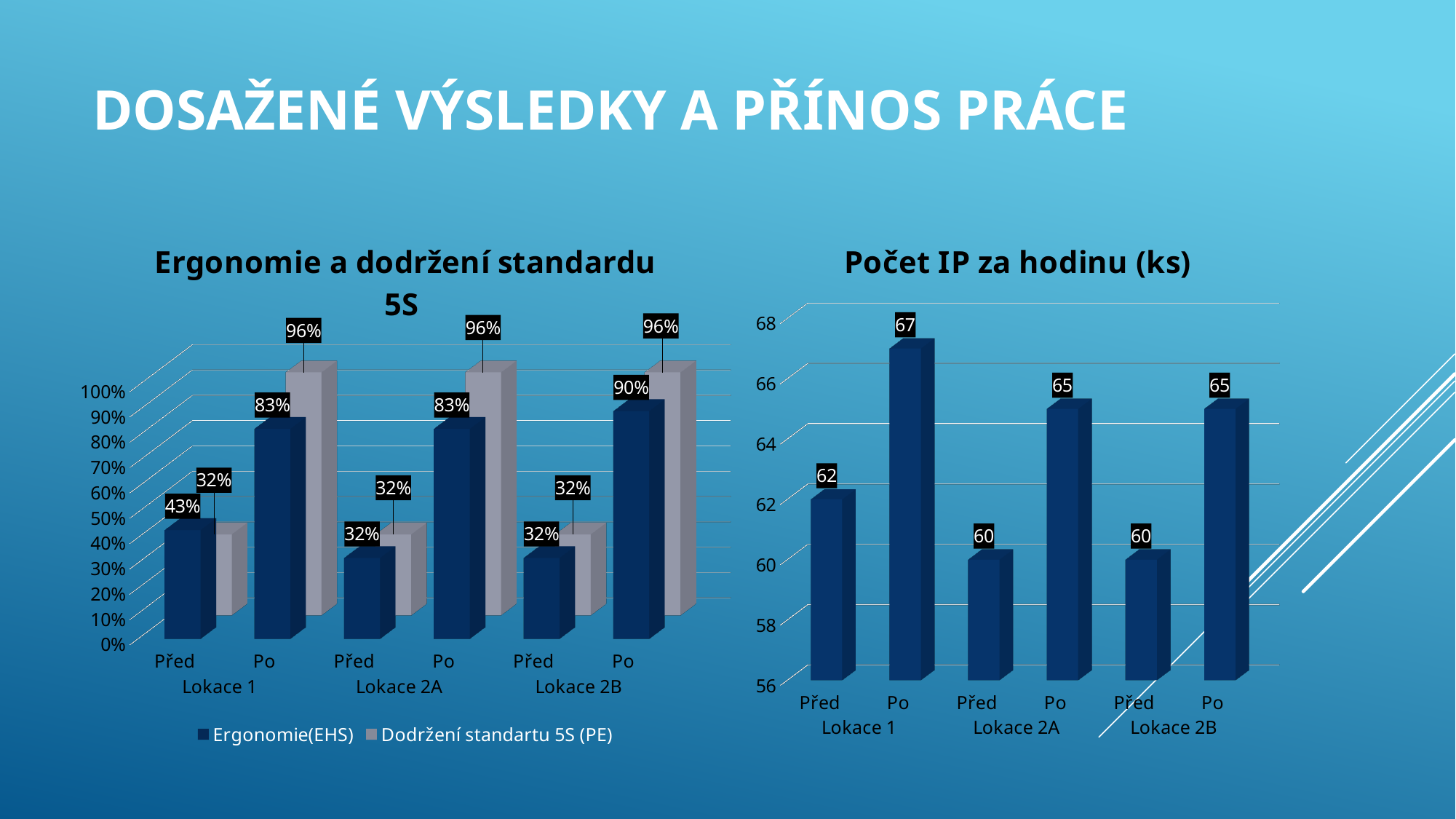
In the chart 'Počet IP za hodinu (ks)', what is the value for Po at Lokace 1? 67 In the chart 'Počet IP za hodinu (ks)', which category has the highest value? Po, Lokace 1 In the chart 'Ergonomie a dodržení standardu 5S', which is larger for Po at Lokace 1: Ergonomie(EHS) or Dodržení standartu 5S (PE)? Dodržení standartu 5S (PE) In the chart 'Ergonomie a dodržení standardu 5S', what is the Ergonomie(EHS) value for Před at Lokace 1? 43% In the chart 'Ergonomie a dodržení standardu 5S', what is the Ergonomie(EHS) value for Po at Lokace 2B? 90% In the chart 'Ergonomie a dodržení standardu 5S', what is the difference between the Ergonomie(EHS) values for Po and Před at Lokace 2A? 51% In the chart 'Počet IP za hodinu (ks)', what is the value for Před at Lokace 2A? 60 What kind of chart is 'Počet IP za hodinu (ks)'? bar chart In the chart 'Ergonomie a dodržení standardu 5S', what is the Dodržení standartu 5S (PE) value for Po at Lokace 2B? 96% In the chart 'Ergonomie a dodržení standardu 5S', how many series does the legend list? 2 In the chart 'Počet IP za hodinu (ks)', how many bars are plotted? 6 In the chart 'Počet IP za hodinu (ks)', what is the difference between Po and Před at Lokace 1? 5